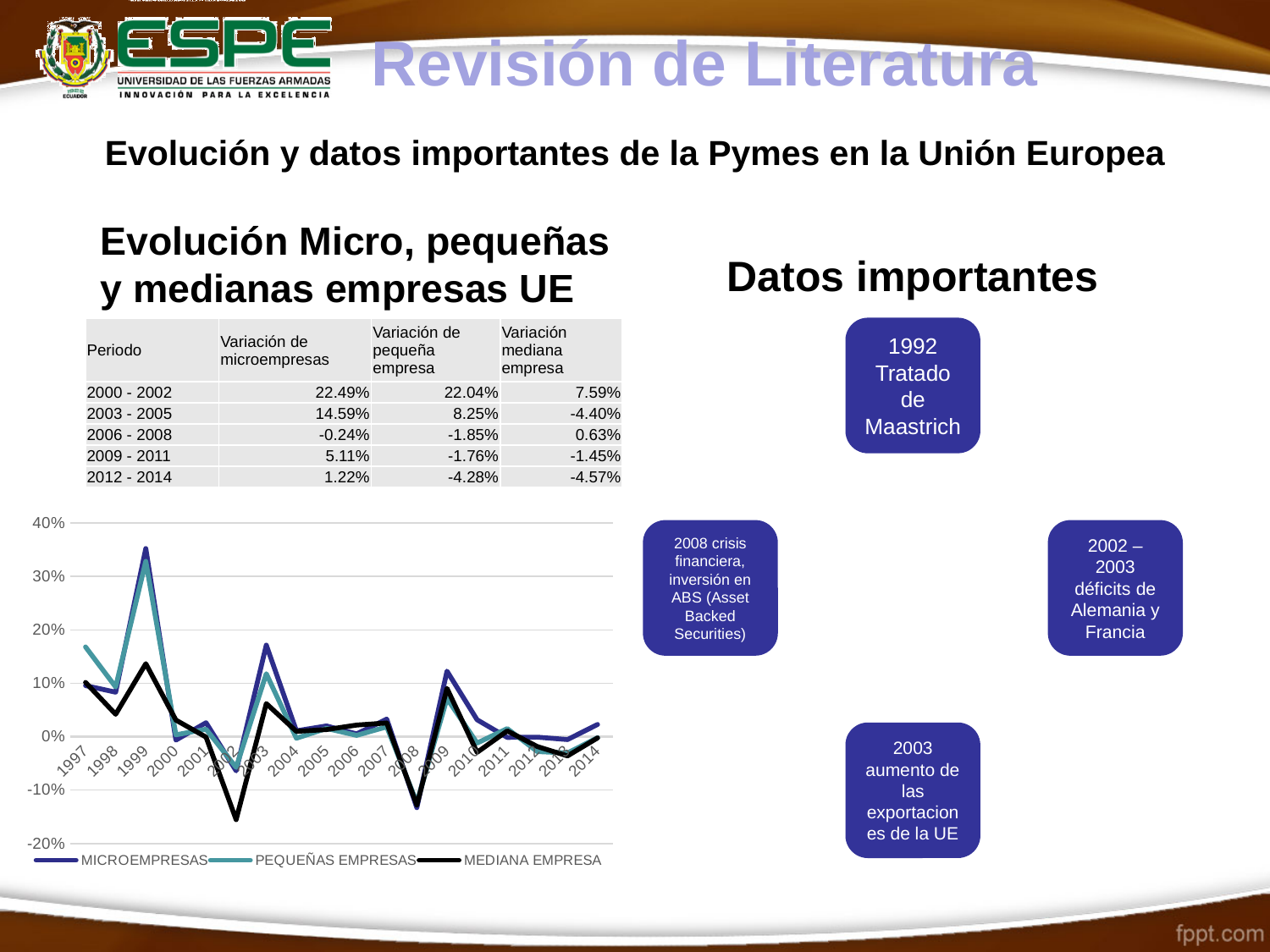
How many series does the chart's legend list? 3 Between 1999 and 2000, does the MICROEMPRESAS line rise or fall? fall In 1999, which series has the higher value, MICROEMPRESAS or MEDIANA EMPRESA? MICROEMPRESAS What are the three series named in the chart's legend? MICROEMPRESAS, PEQUEÑAS EMPRESAS, MEDIANA EMPRESA What kind of chart is shown on the slide? line chart Is the value for MICROEMPRESAS in 2003 greater or less than 10%? greater How many years are plotted along the x axis of the chart? 18 In which year does the MICROEMPRESAS line reach its highest value? 1999 Is the value for PEQUEÑAS EMPRESAS in 1997 greater or less than 10%? greater In which year does the MEDIANA EMPRESA line reach its lowest value? 2002 Is the value for MEDIANA EMPRESA in 2002 greater or less than -10%? less